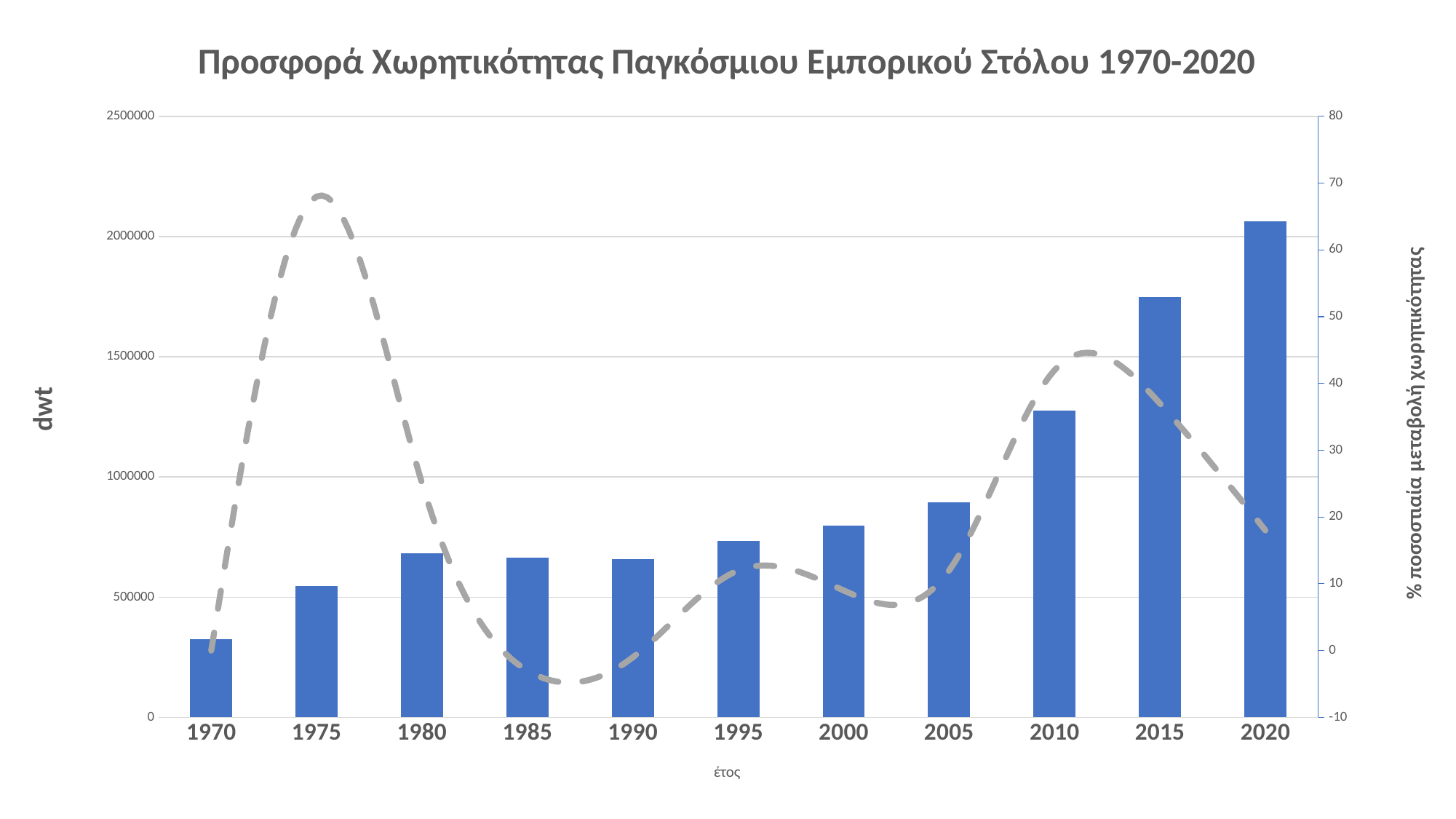
What kind of chart is shown on the slide? A combination bar and line chart Which year has the shortest bar in the chart? 1970 Which year has the tallest bar in the chart? 2020 Is the bar value for 2015 greater or less than 1500000 dwt? greater What is the title of the chart? Προσφορά Χωρητικότητας Παγκόσμιου Εμπορικού Στόλου 1970-2020 Is the bar value for 2020 greater or less than 2000000 dwt? greater Is the bar value for 2005 greater or less than 1000000 dwt? less Do the bar values generally rise or fall from 1995 to 2020? rise How many years are shown on the x axis? 11 Which bar is taller, 2010 or 2015? 2015